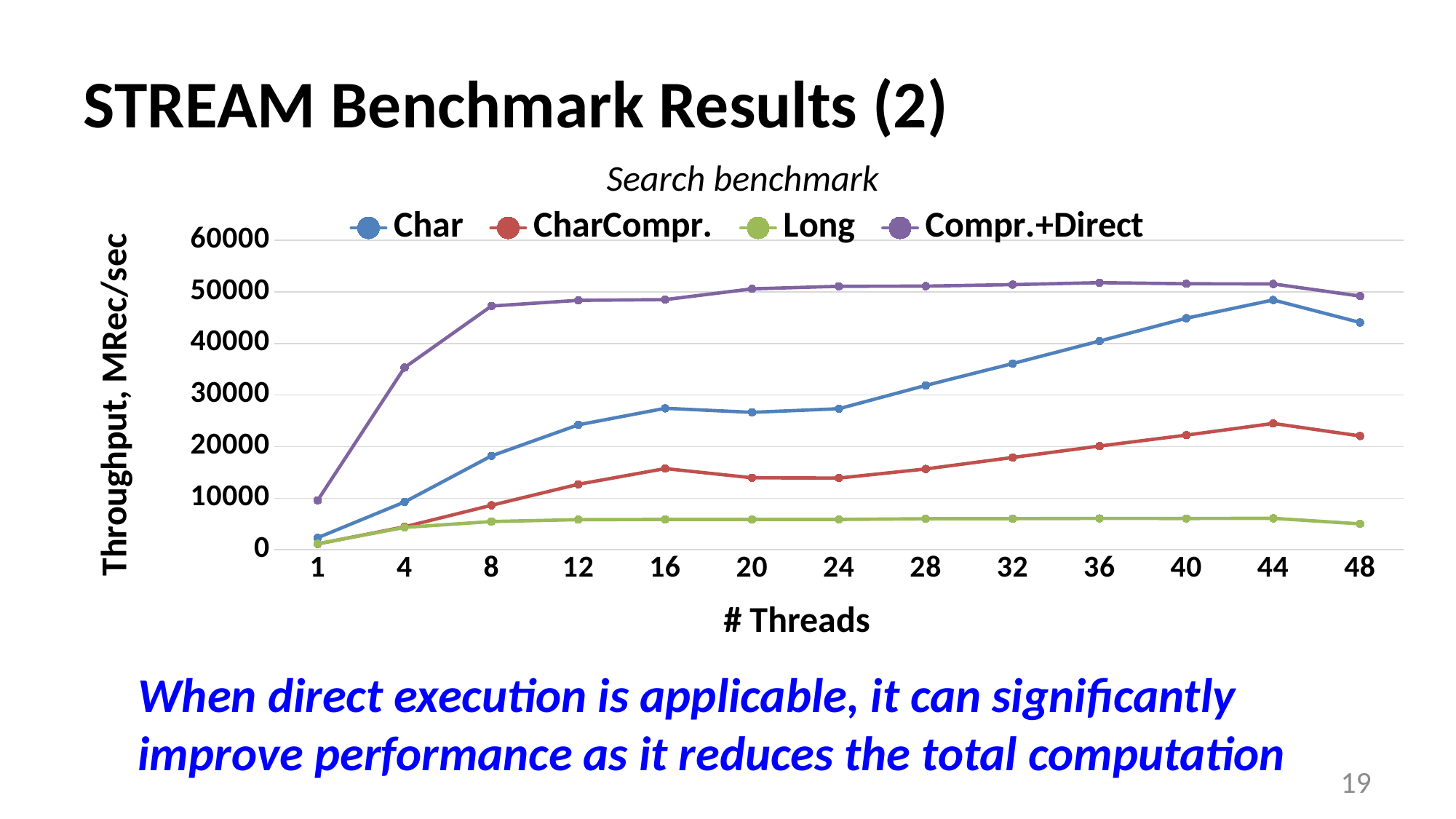
Is the value for CharCompr. at 16 threads greater or less than 10000? greater How many series does the legend list? 4 How many thread counts are plotted along the x axis? 13 Which series has the highest throughput at 48 threads? Compr.+Direct Does the Compr.+Direct series rise or fall from 1 to 8 threads? rise What is the title of the chart? Search benchmark What kind of chart is shown on the slide? line chart At 8 threads, which series has the larger throughput, Char or CharCompr.? Char Is the value for Compr.+Direct at 1 thread greater or less than 20000? less Which series has the lowest throughput at 48 threads? Long Is the value for Long at 48 threads greater or less than 10000? less